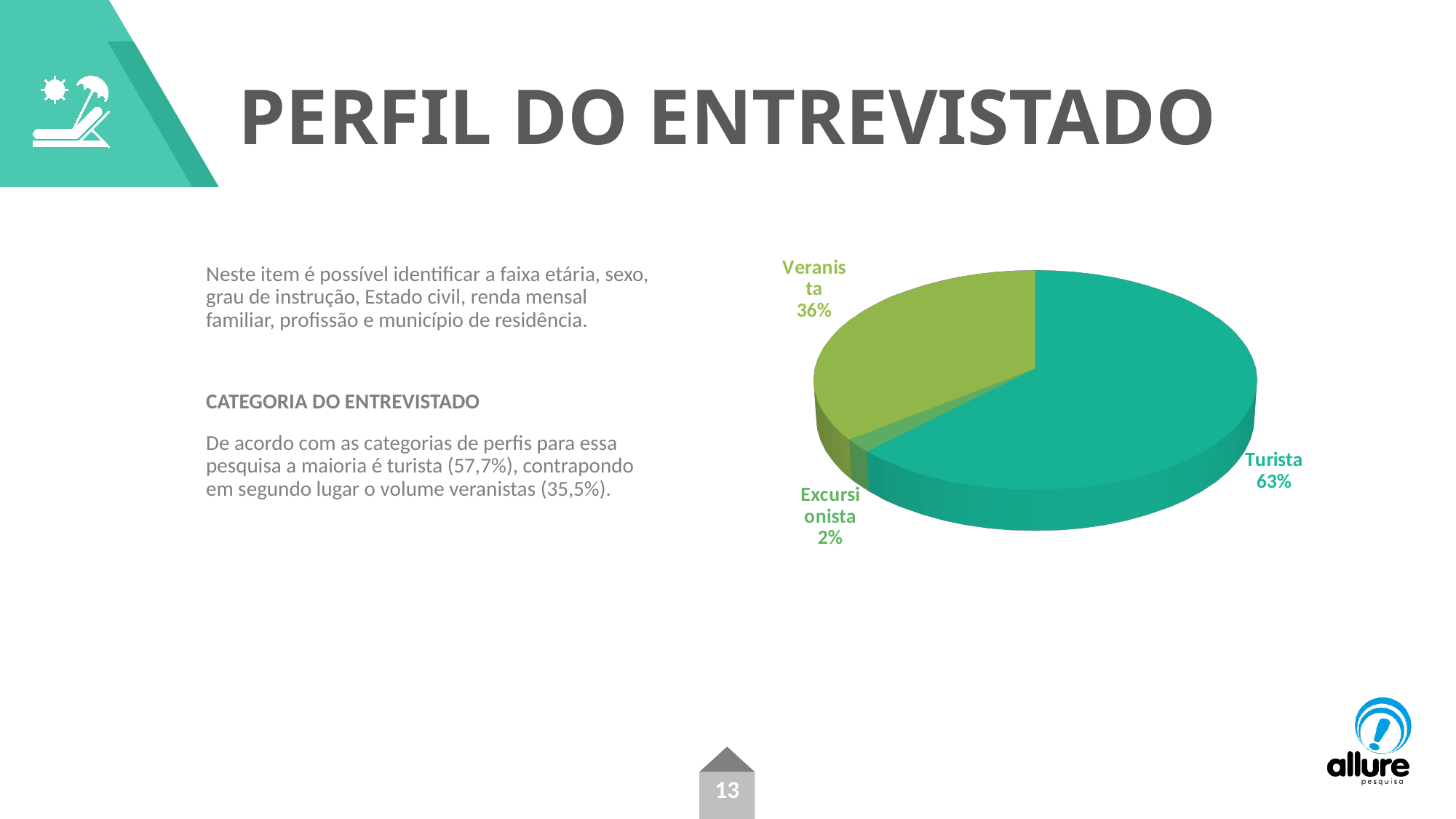
What colour is the Veranista slice? Green Which is larger, the Veranista slice or the Excursionista slice? Veranista Which category has the smallest slice of the pie? Excursionista How many categories are shown in the pie chart? 3 What share of the pie does Veranista represent? 36% What colour is the Turista slice? Teal What is the difference in percentage points between Veranista and Excursionista? 34 What share of the pie does Turista represent? 63% What kind of chart is shown on the slide? Pie chart What is the difference in percentage points between Turista and Veranista? 27 What share of the pie does Excursionista represent? 2% Which category has the largest slice of the pie? Turista